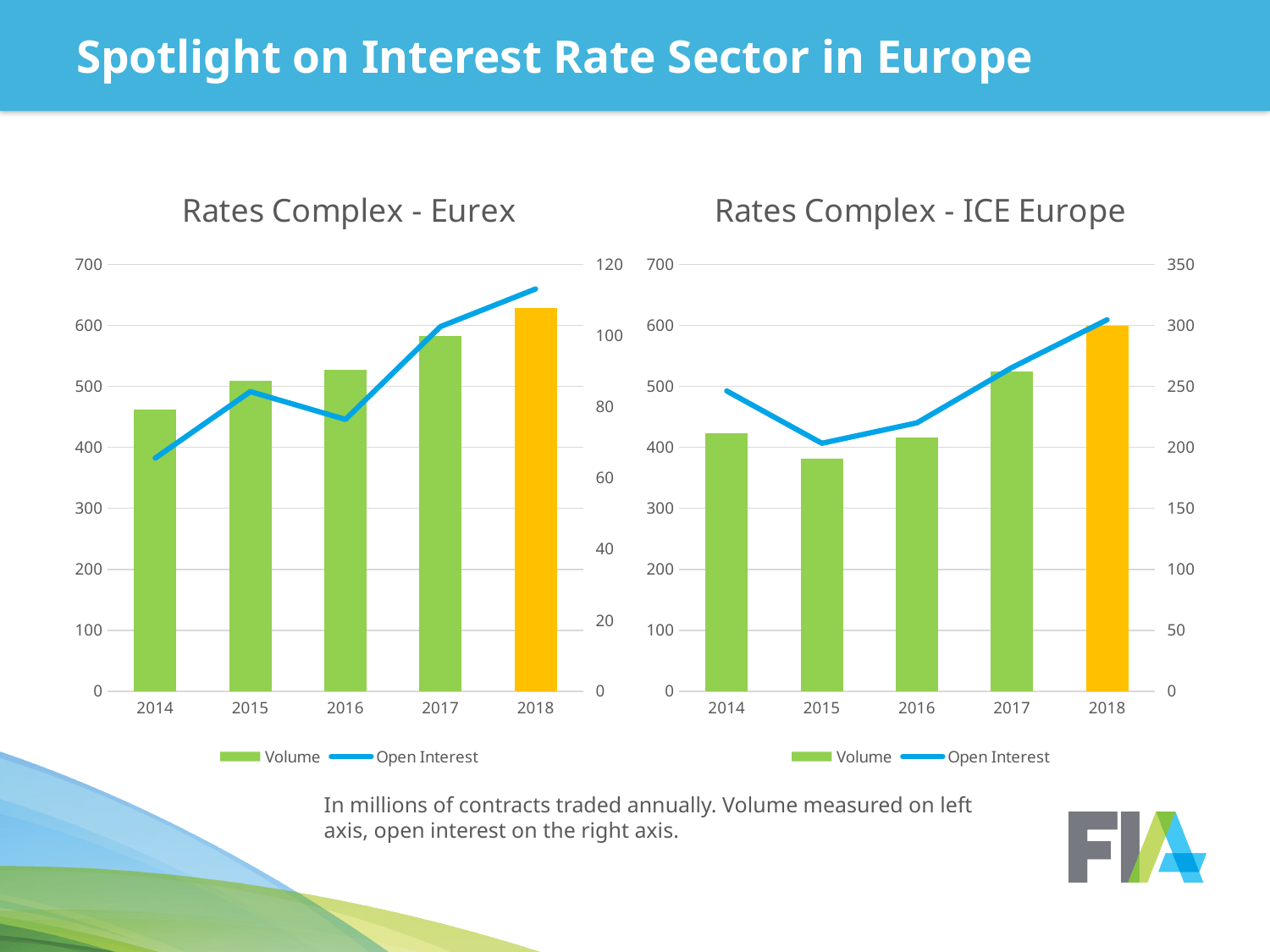
How many years are shown on the x axis of the Rates Complex - ICE Europe chart? 5 In the Rates Complex - ICE Europe chart, is the Volume for 2015 greater or less than 400? less In the Rates Complex - Eurex chart, is the Volume for 2014 greater or less than 500? less In the Rates Complex - ICE Europe chart, is the Open Interest for 2014 greater or less than 200? greater How many series does the legend of the Rates Complex - Eurex chart list? 2 In the Rates Complex - ICE Europe chart, which year has the highest Volume bar? 2018 In the Rates Complex - ICE Europe chart, which year has the lowest Volume bar? 2015 In the Rates Complex - Eurex chart, which year has the lowest Volume bar? 2014 In the Rates Complex - Eurex chart, which year has the larger Volume, 2015 or 2017? 2017 In the Rates Complex - Eurex chart, which year has the highest Volume bar? 2018